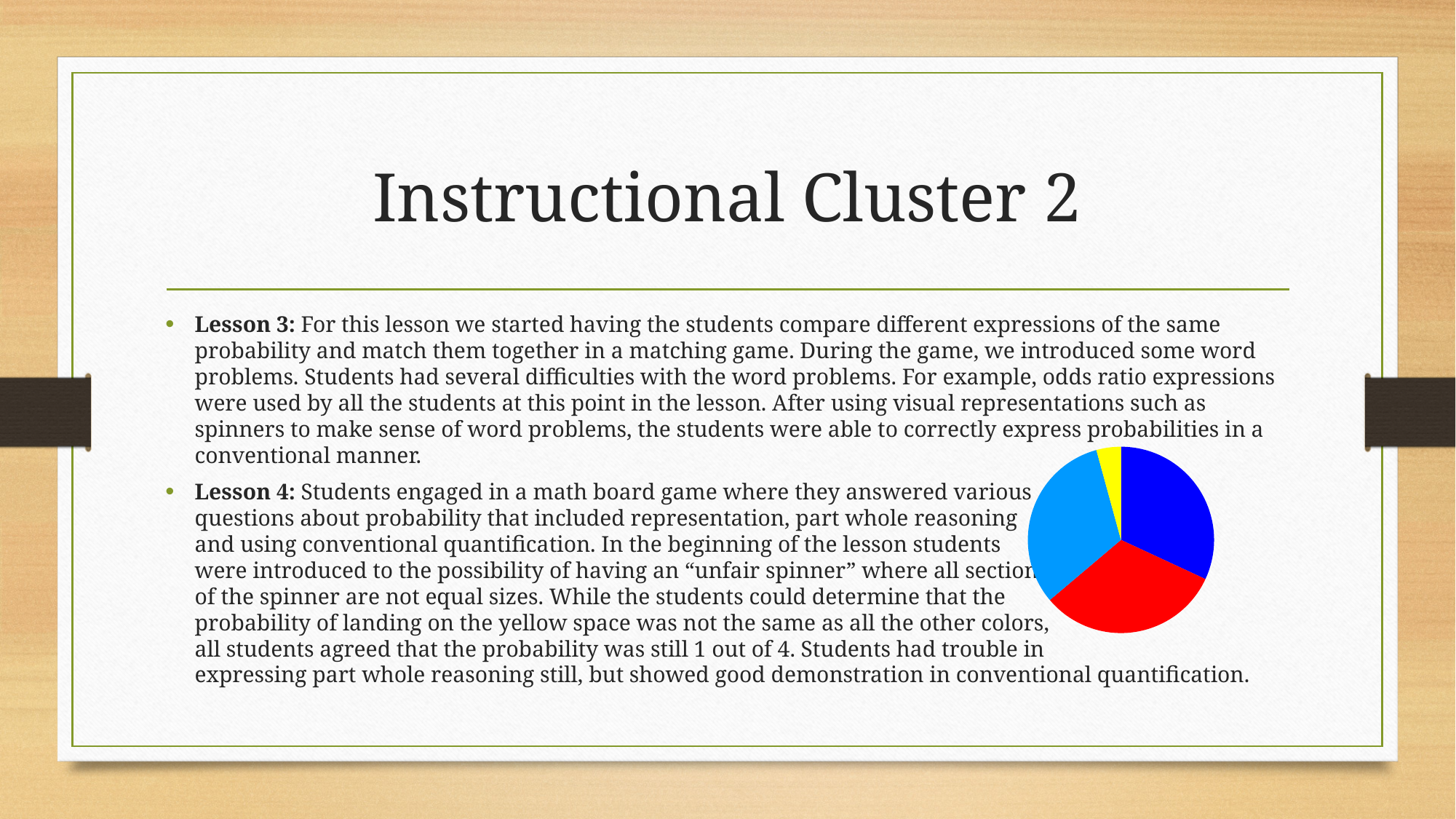
How many slices does the pie chart have? 4 What colours are the slices of the pie chart? dark blue, red, light blue, yellow What kind of chart is shown on the slide? pie chart In the pie chart, which is larger, the yellow slice or the dark blue slice? dark blue In the pie chart, which is larger, the yellow slice or the red slice? red Which colour slice of the pie chart is the smallest? yellow In the pie chart, which is larger, the yellow slice or the light blue slice? light blue Does the pie chart on the slide have a legend or data labels? No